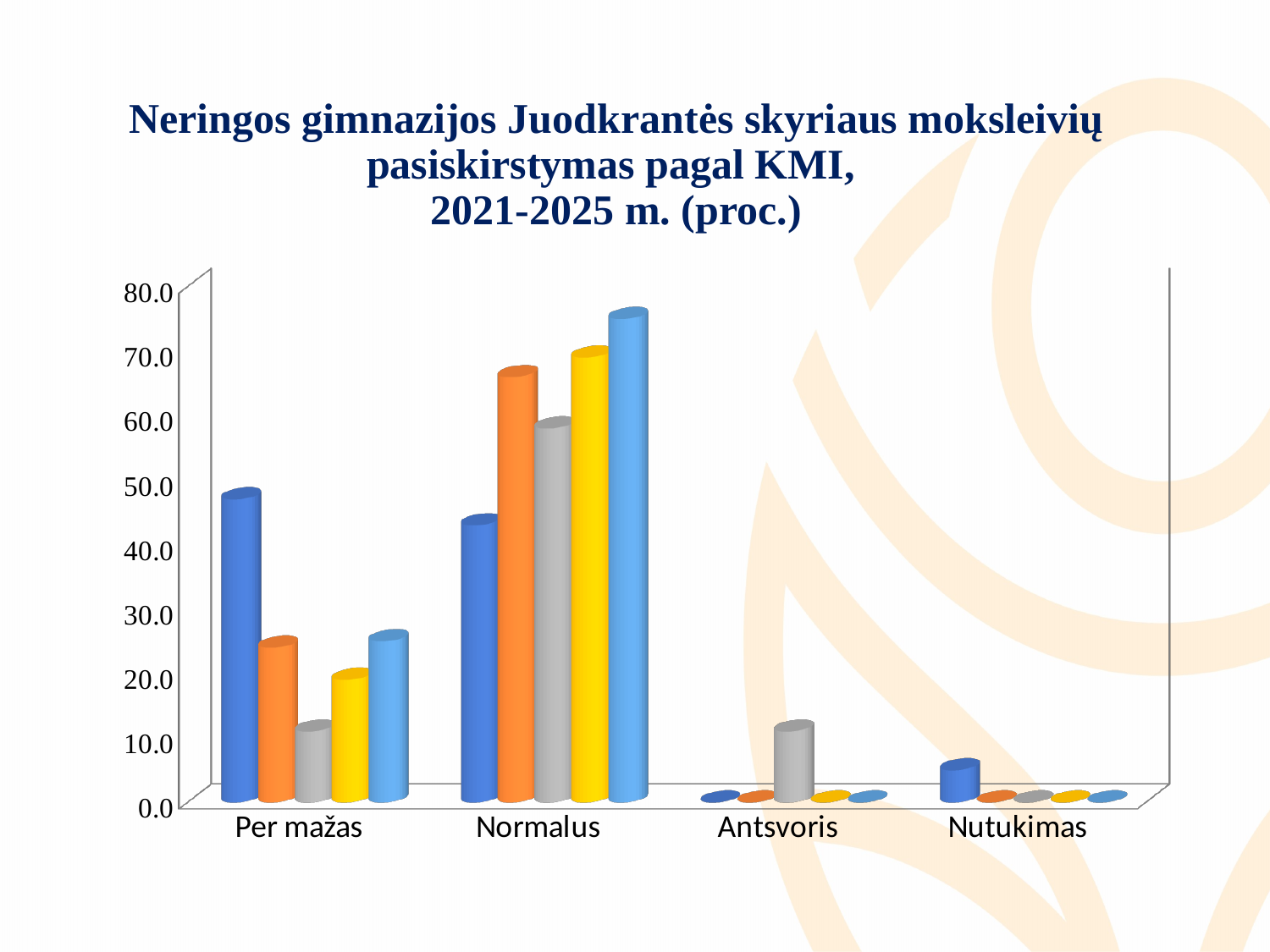
What kind of chart is shown on the slide? bar chart Is the value of the dark blue bar for Nutukimas greater or less than 10.0? less Is the value of the gray bar for Per mažas greater or less than 20.0? less What is the highest value shown on the vertical axis of the chart? 80.0 Is the value of the dark blue bar for Per mažas greater or less than 40.0? greater For Normalus, which is larger: the dark blue bar or the light blue bar? the light blue bar Which category contains the tallest bar in the chart? Normalus How many bars (series) are plotted for each category in the chart? 5 For Per mažas, which is larger: the dark blue bar or the orange bar? the dark blue bar How many categories are shown on the x axis of the chart? 4